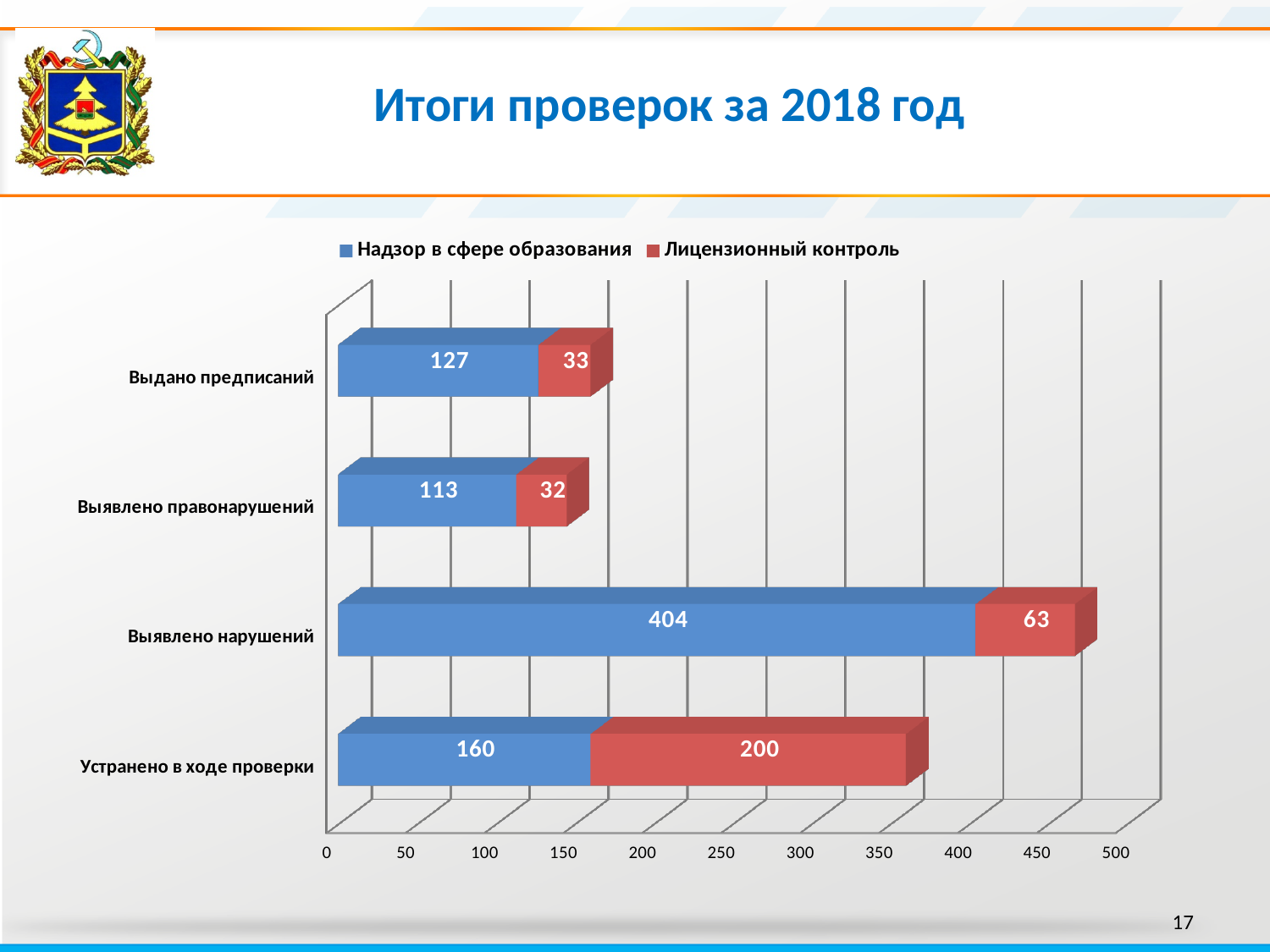
What is the difference between the «Надзор в сфере образования» and «Лицензионный контроль» values in the «Выявлено нарушений» category? 341 Which category has the lowest value for «Лицензионный контроль»? Выявлено правонарушений What is the total of the stacked bar for «Выдано предписаний»? 160 How many series does the legend list? 2 What value is shown for «Надзор в сфере образования» in the «Выявлено нарушений» category? 404 What kind of chart is shown on the slide? Stacked bar chart What value is shown for «Лицензионный контроль» in the «Выдано предписаний» category? 33 What value is shown for «Лицензионный контроль» in the «Устранено в ходе проверки» category? 200 How many categories are shown on the chart? 4 What value is shown for «Надзор в сфере образования» in the «Выявлено правонарушений» category? 113 Which category has the highest value for «Надзор в сфере образования»? Выявлено нарушений In the «Устранено в ходе проверки» category, which series has the larger value? Лицензионный контроль